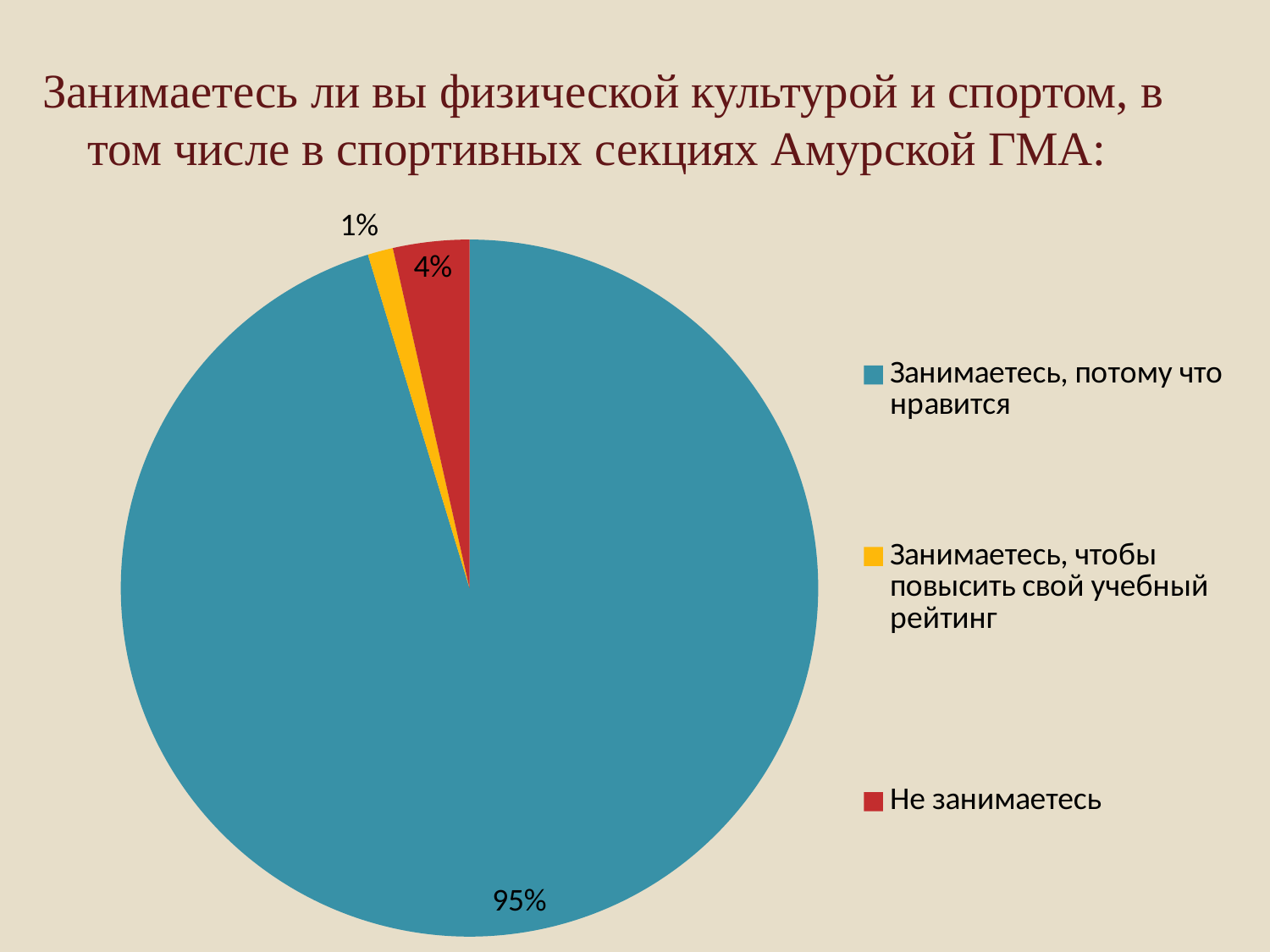
What colour is the slice for "Занимаетесь, чтобы повысить свой учебный рейтинг"? Yellow Which category has the largest slice of the pie? Занимаетесь, потому что нравится What kind of chart is shown on the slide? Pie chart Which category has the smallest slice of the pie? Занимаетесь, чтобы повысить свой учебный рейтинг What is the difference in percentage points between the "Не занимаетесь" slice and the "Занимаетесь, чтобы повысить свой учебный рейтинг" slice? 3% What share of the pie is labelled "Не занимаетесь"? 4% What share of the pie is labelled "Занимаетесь, чтобы повысить свой учебный рейтинг"? 1% Which slice is larger: "Не занимаетесь" or "Занимаетесь, чтобы повысить свой учебный рейтинг"? Не занимаетесь What share of the pie is labelled "Занимаетесь, потому что нравится"? 95% How many slices does the pie chart have? 3 How many entries does the legend list? 3 What colour is the slice for "Не занимаетесь"? Red